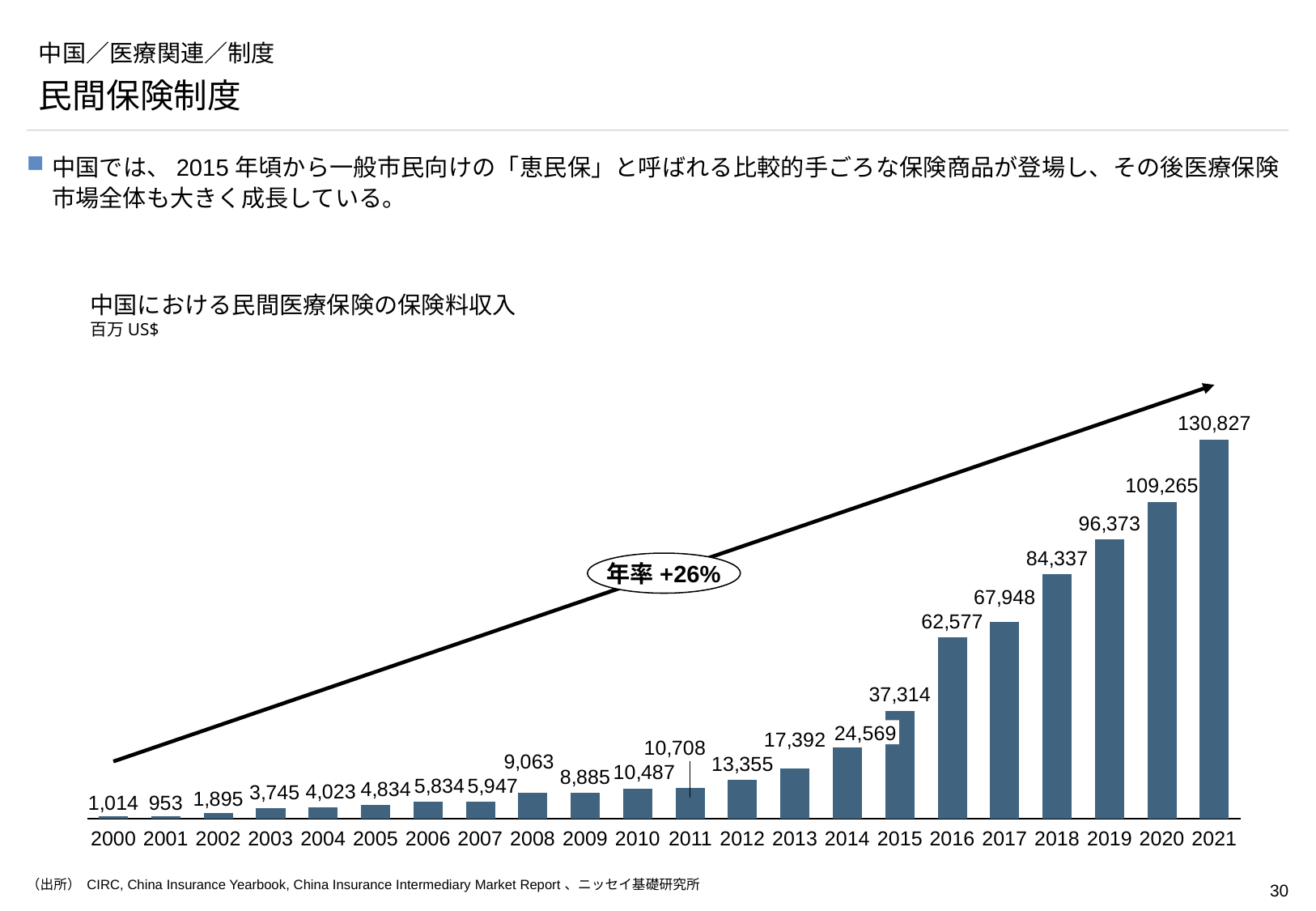
What annual growth rate is written in the oval annotation on the chart? 年率 +26% What is the value for 2015? 37,314 What kind of chart is this? Bar chart What is the difference between the values for 2016 and 2015? 25,263 Which year has the lowest value? 2001 Which year has the highest value? 2021 Do the values generally rise or fall from 2000 to 2021? Rise What is the difference between the values for 2021 and 2020? 21,562 Which is larger, the value for 2008 or the value for 2009? 2008 What is the value for 2008? 9,063 How many years are shown on the x axis? 22 What is the value for 2021? 130,827